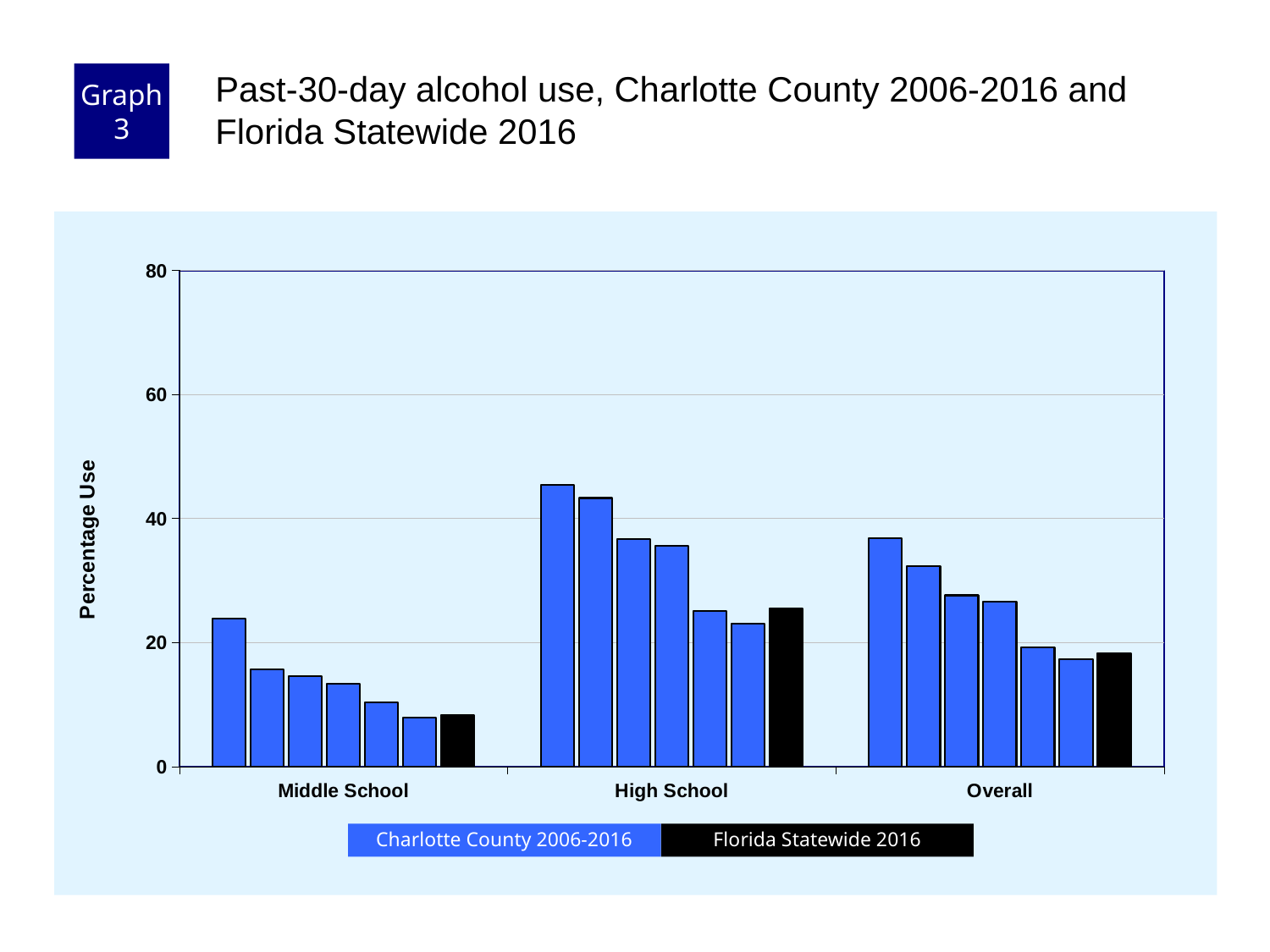
Is the first Charlotte County bar for Middle School greater or less than 20? greater How many series does the legend list? 2 Which category has the tallest bars overall? High School How many categories are shown along the x axis? 3 Is the first Charlotte County bar for High School greater or less than 40? greater Is the first Charlotte County bar for Overall greater or less than 40? less Which is larger, the Florida Statewide 2016 value for High School or for Middle School? High School Which category has the shortest bars overall? Middle School What kind of chart is shown on the slide? bar chart Do the Charlotte County bars within each category rise or fall from left to right? fall What is the label on the y axis? Percentage Use